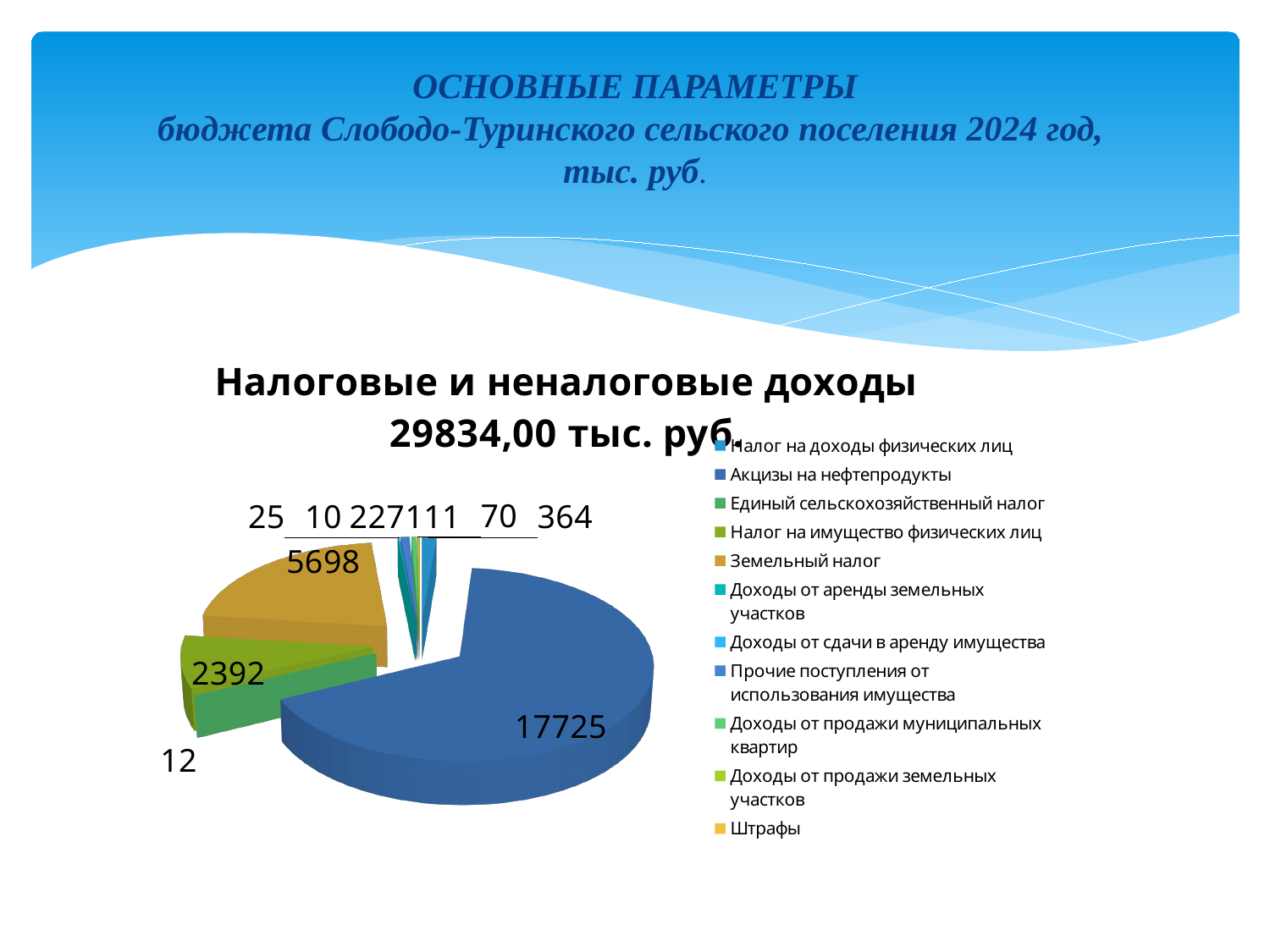
What is the smallest value labelled on the pie chart? 10 Which is larger, the slice labelled 364 or the slice labelled 227? 364 Which category has the largest slice in the pie chart? Акцизы на нефтепродукты How many categories does the chart legend list? 11 What kind of chart is shown on the slide? Pie chart What is the difference between the slice labelled 5698 and the slice labelled 2392? 3306 What total amount of tax and non-tax revenue is stated in the chart title? 29834,00 тыс. руб. What is the value shown for Земельный налог? 5698 What is the value of the largest slice in the pie chart? 17725 Which is larger, the slice labelled 5698 or the slice labelled 2392? 5698 What is the difference between the slice labelled 17725 and the slice labelled 5698? 12027 What is the title of the chart? Налоговые и неналоговые доходы 29834,00 тыс. руб.